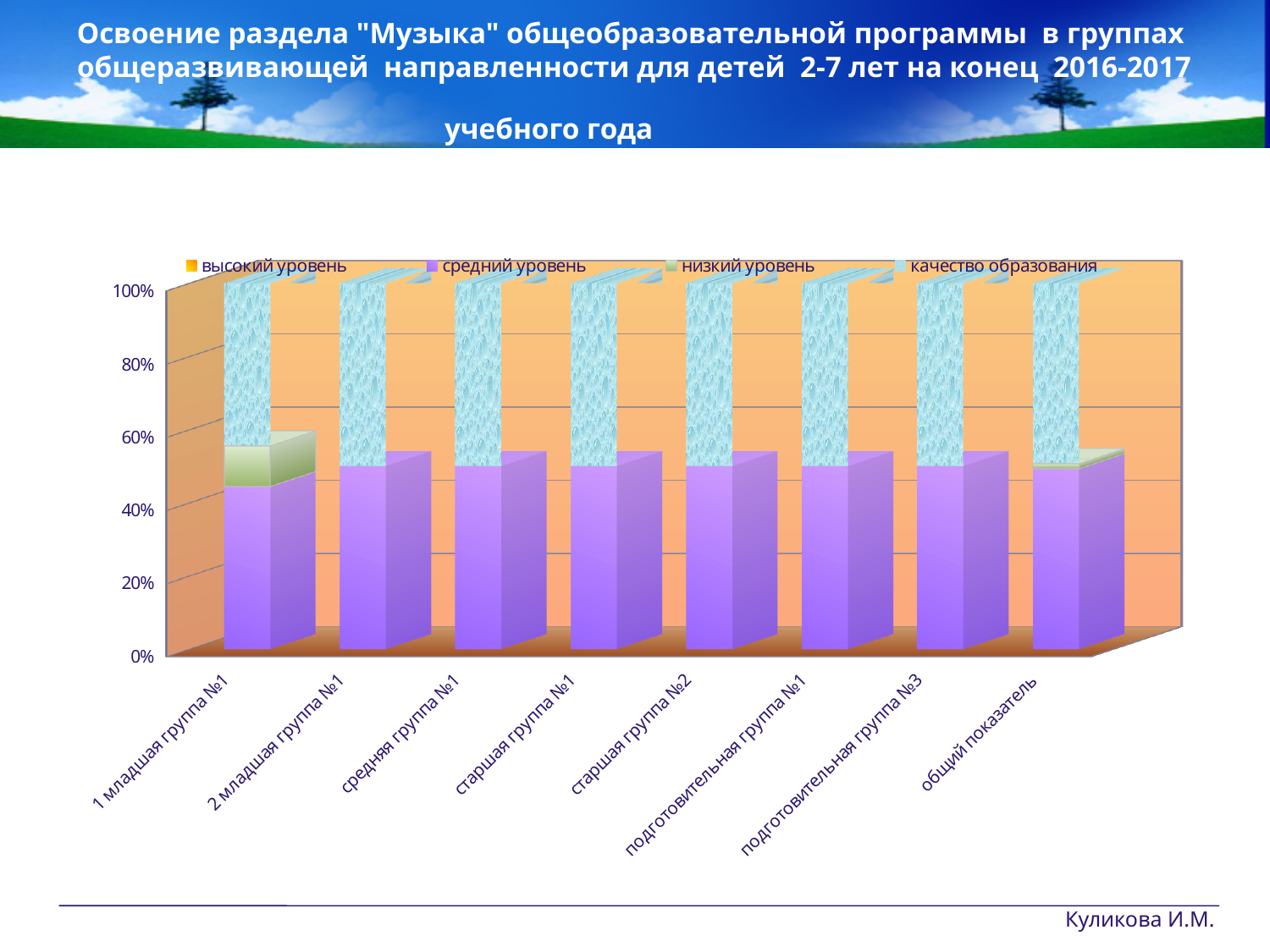
Is the value of средний уровень for старшая группа №2 greater or less than 80%? less Is the value of низкий уровень for 1 младшая группа №1 greater or less than 20%? less Is the value of средний уровень for 1 младшая группа №1 greater or less than 60%? less How many series does the chart legend list? 4 How many categories are shown along the x axis of the chart? 8 What kind of chart is shown on the slide? bar chart What is the first series listed in the chart legend? высокий уровень What is the last category on the x axis of the chart? общий показатель